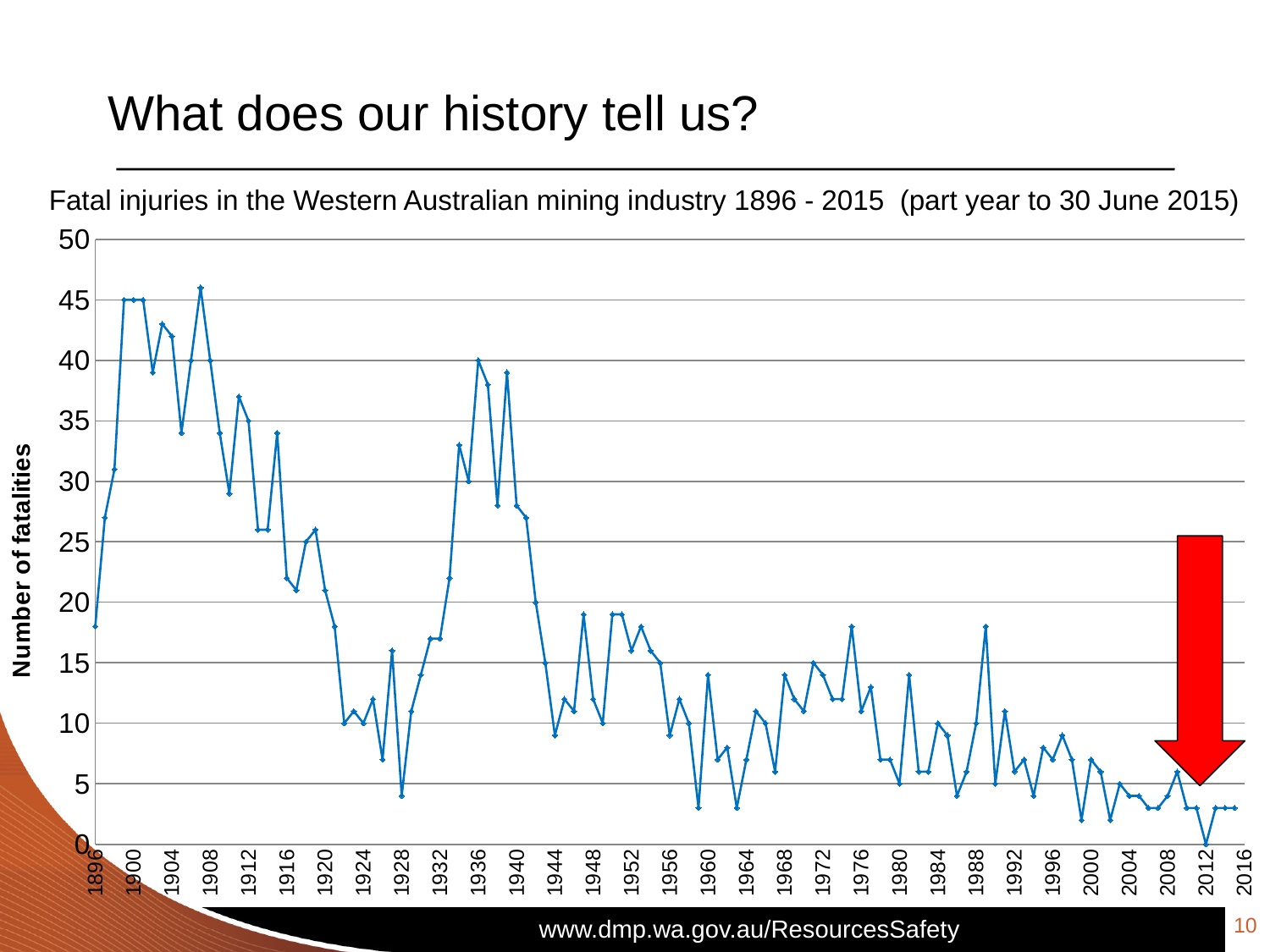
What is the label on the vertical axis of the chart? Number of fatalities In which year was the number of fatalities lowest? 2012 Overall, do the number of fatalities rise or fall from 1896 to 2015? fall Is the number of fatalities in 1896 greater or less than 25? less What kind of chart is shown on the slide? line chart Which year had more fatalities, 1937 or 1976? 1937 Is the number of fatalities in 1907 greater or less than 40? greater Is the number of fatalities in 1937 greater or less than 35? greater What is the title of the chart? Fatal injuries in the Western Australian mining industry 1896 - 2015 (part year to 30 June 2015) Which year had more fatalities, 1900 or 1944? 1900